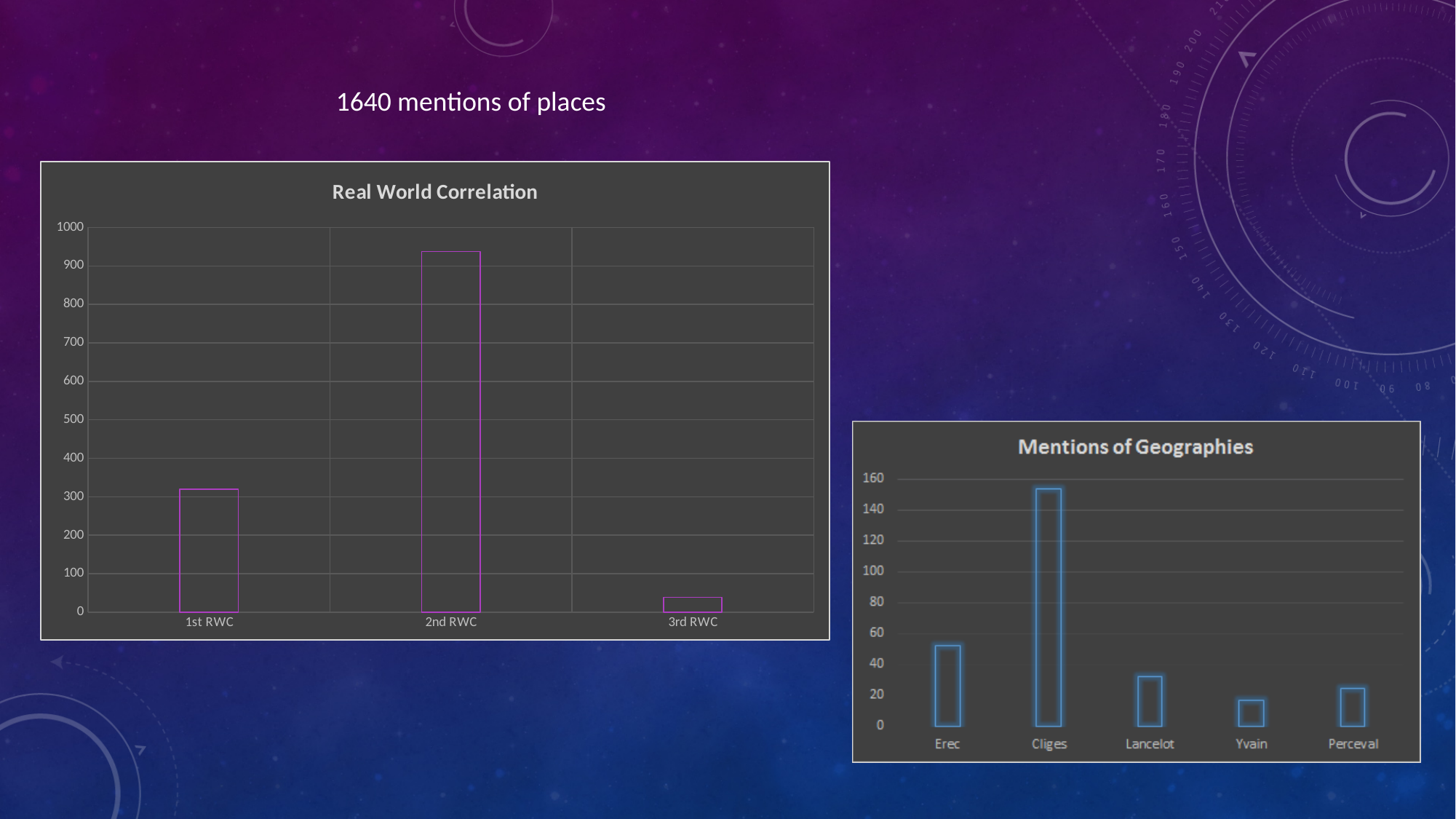
In the 'Real World Correlation' chart, is the value for 2nd RWC greater or less than 900? greater How many categories are shown in the 'Mentions of Geographies' chart? 5 In the 'Mentions of Geographies' chart, which category has the highest value? Cliges In the 'Real World Correlation' chart, which category has the highest value? 2nd RWC In the 'Real World Correlation' chart, which category has the lowest value? 3rd RWC In the 'Mentions of Geographies' chart, which category has the lowest value? Yvain In the 'Real World Correlation' chart, is the value for 3rd RWC greater or less than 100? less In the 'Real World Correlation' chart, is the value for 1st RWC greater or less than 400? less How many categories are shown in the 'Real World Correlation' chart? 3 In the 'Mentions of Geographies' chart, which is larger, the value for Erec or the value for Lancelot? Erec What kind of chart is the 'Real World Correlation' chart? bar chart